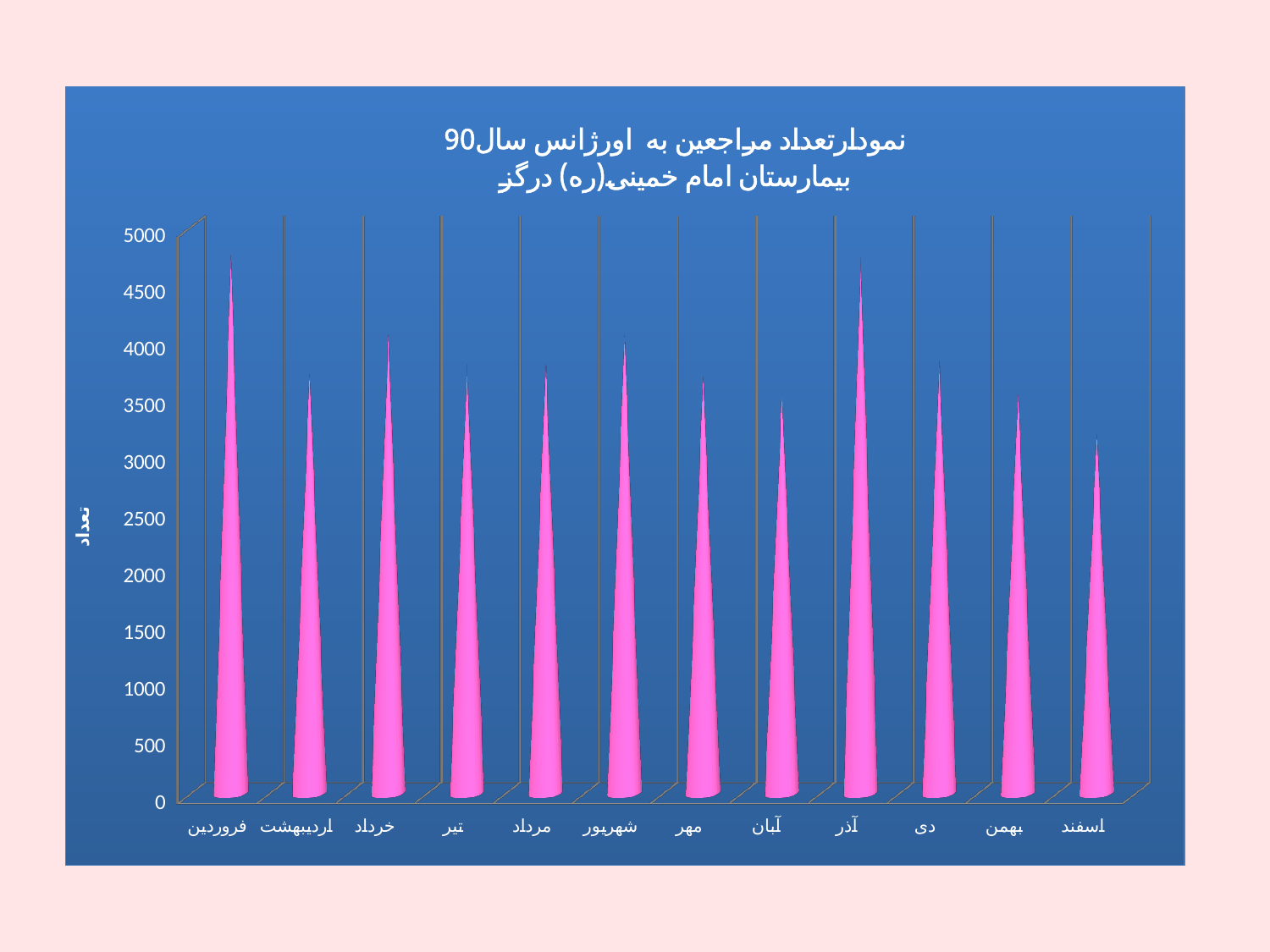
Which is larger, the value for فروردین or the value for اسفند? فروردین Which is larger, the value for آذر or the value for آبان? آذر Is the value for آبان greater or less than 4000? less What is the label on the vertical axis? تعداد What kind of chart is shown on the slide? bar chart Which month has the lowest value? اسفند What colour are the bars in the chart? pink Is the value for آذر greater or less than 4500? greater How many months (categories) are shown on the x axis? 12 Is the value for اسفند greater or less than 3500? less